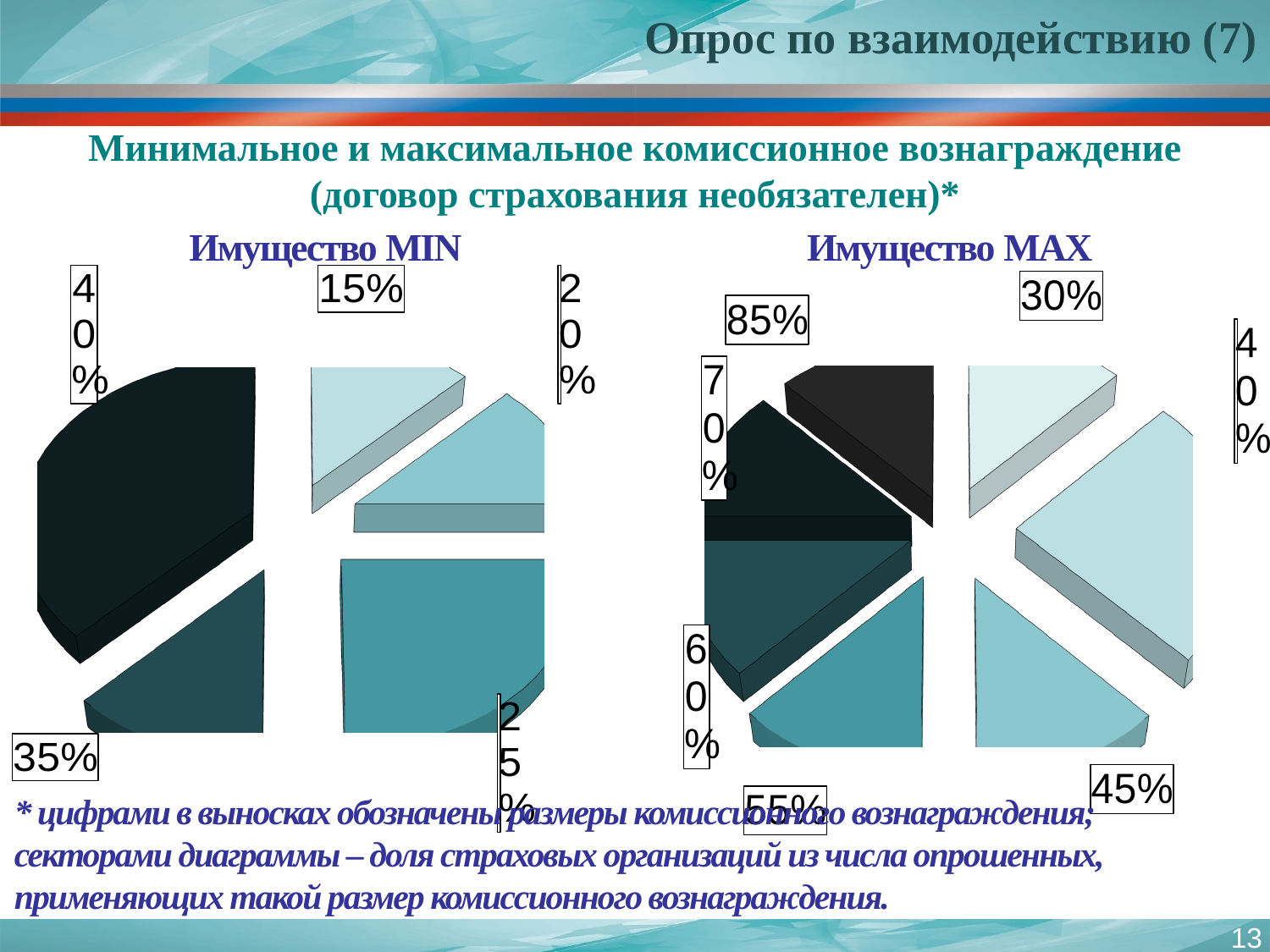
What is the title of the pie chart on the right of the slide? Имущество MAX What kind of chart is the "Имущество MAX" chart? pie chart In the "Имущество MIN" chart, which labelled slice is the largest? 40% Which of the two pie charts has more slices? Имущество MAX What kind of chart is the "Имущество MIN" chart? pie chart What is the title of the pie chart on the left of the slide? Имущество MIN How many slices does the "Имущество MIN" pie chart have? 5 In the "Имущество MIN" chart, which slice is larger: the one labelled 40% or the one labelled 15%? 40% How many slices does the "Имущество MAX" pie chart have? 7